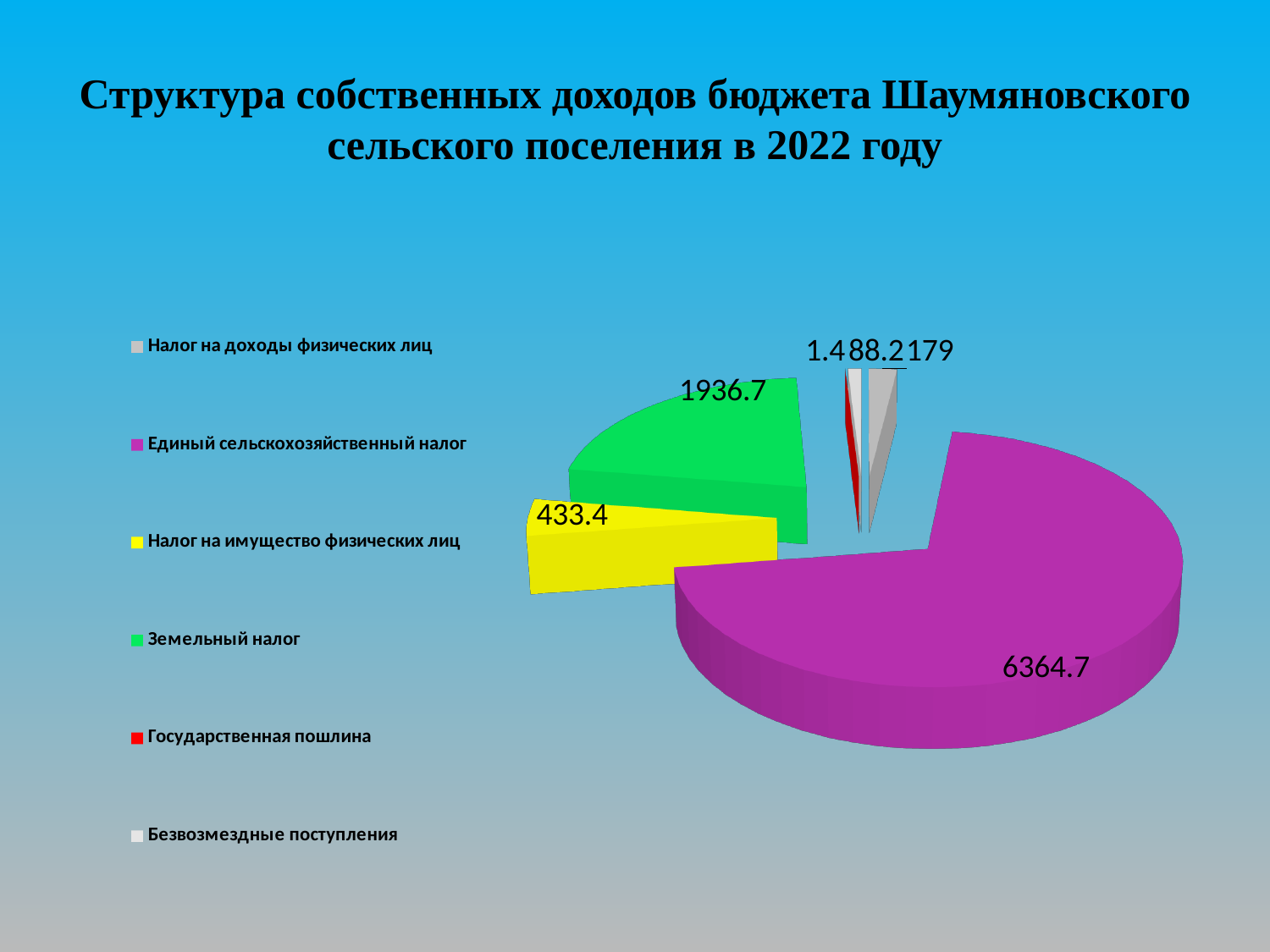
What is the difference between the values for Земельный налог and Налог на имущество физических лиц? 1503.3 What is the value for Единый сельскохозяйственный налог? 6364.7 Which category has the smallest slice of the pie? Государственная пошлина What is the difference between the values for Единый сельскохозяйственный налог and Земельный налог? 4428 How many categories does the pie chart contain? 6 How many entries does the legend list? 6 What is the value for Налог на имущество физических лиц? 433.4 What colour is the slice for Единый сельскохозяйственный налог? Magenta (purple) What type of chart is shown on the slide? Pie chart Which category has the largest slice of the pie? Единый сельскохозяйственный налог Which is larger: Земельный налог or Налог на имущество физических лиц? Земельный налог What is the value for Земельный налог? 1936.7